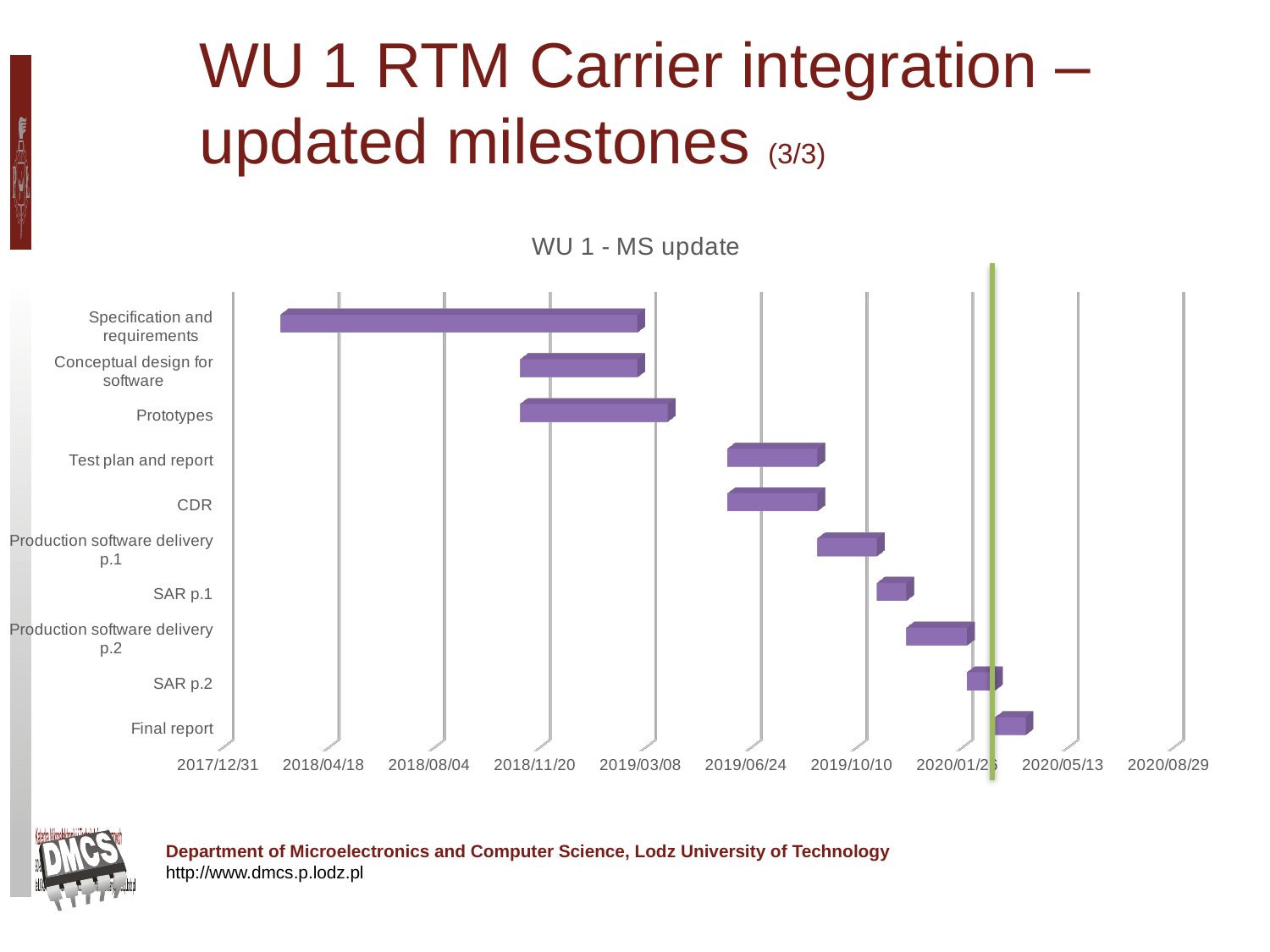
Going down the list of tasks from top to bottom, do the bars move to later or earlier dates? later Which task's bar ends latest on the time axis? Final report Which task has the longest bar in the chart? Specification and requirements Which bar is longer, Production software delivery p.1 or SAR p.1? Production software delivery p.1 Which task's bar starts earliest on the time axis? Specification and requirements Which bar is longer, Specification and requirements or Prototypes? Specification and requirements What is the title of the chart? WU 1 - MS update What colour are the bars in the chart? purple Does the bar for Test plan and report lie before or after the 2019/10/10 tick on the time axis? before How many tasks (categories) are listed on the vertical axis of the chart? 10 Does the bar for Final report lie before or after the 2020/01/26 tick on the time axis? after What kind of chart is shown on the slide? bar chart